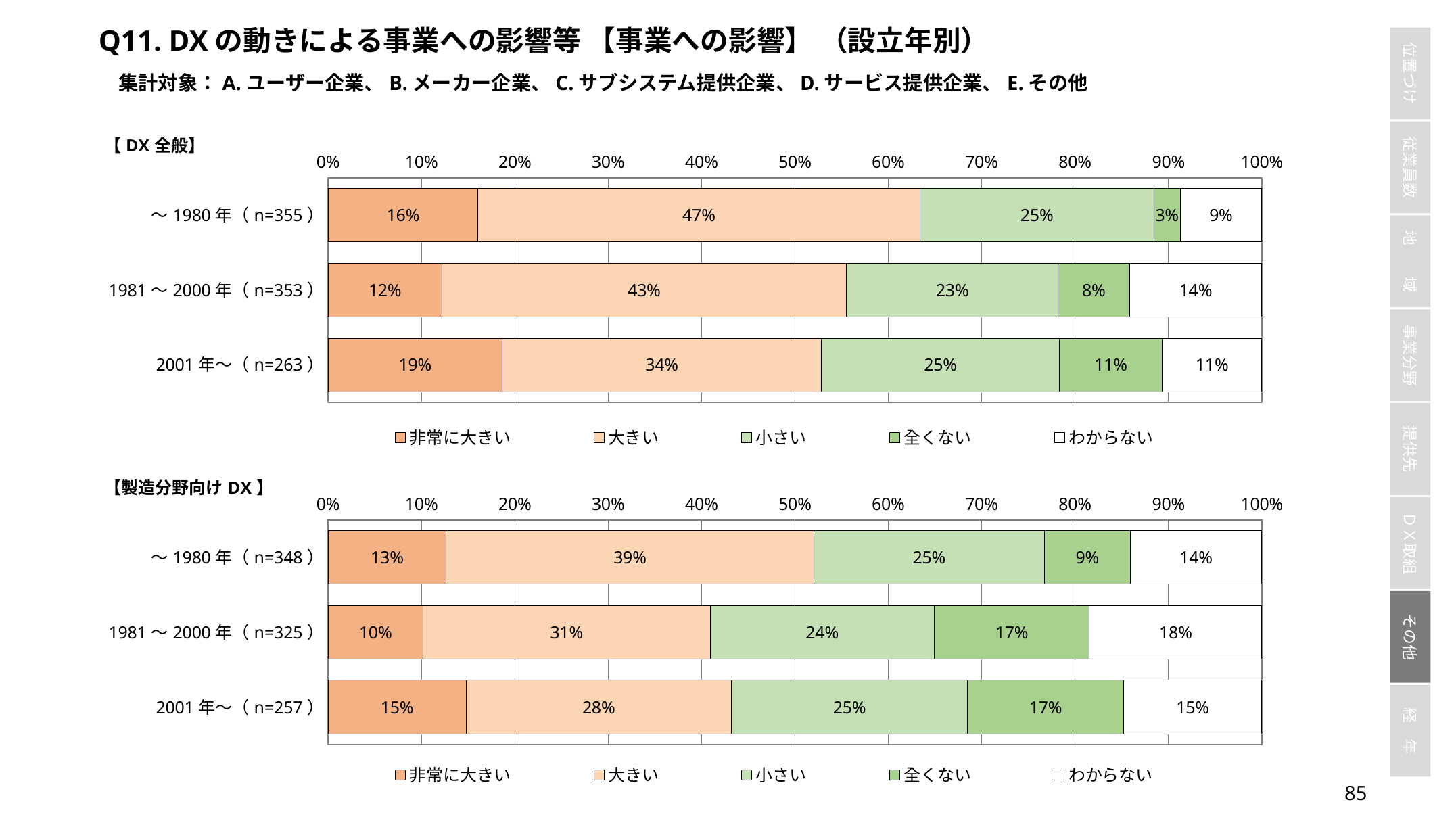
In the 【DX全般】 chart, what percentage of the ～1980年 (n=355) group answered 大きい? 47% In the 【DX全般】 chart, what is the difference between the 大きい shares of the ～1980年 group and the 2001年～ group? 13 percentage points In the 【製造分野向けDX】 chart, what is the combined share of 非常に大きい and 大きい for the ～1980年 (n=348) group? 52% In the 【DX全般】 chart, what percentage of the 2001年～ (n=263) group answered 非常に大きい? 19% In the 【製造分野向けDX】 chart, which group has the lowest share of 非常に大きい? 1981～2000年 (n=325) In the 【DX全般】 chart, how many series does the legend list? 5 In the 【製造分野向けDX】 chart, what percentage of the 2001年～ (n=257) group answered 大きい? 28% In the 【製造分野向けDX】 chart, how many establishment-year groups are shown? 3 In the 【DX全般】 chart, which group has the highest share of 全くない? 2001年～ (n=263) In the 【製造分野向けDX】 chart, which is larger: the 全くない share for ～1980年 or for 1981～2000年? 1981～2000年 What type of chart is used for 【DX全般】? Stacked bar chart In the 【製造分野向けDX】 chart, what percentage of the 1981～2000年 (n=325) group answered わからない? 18%